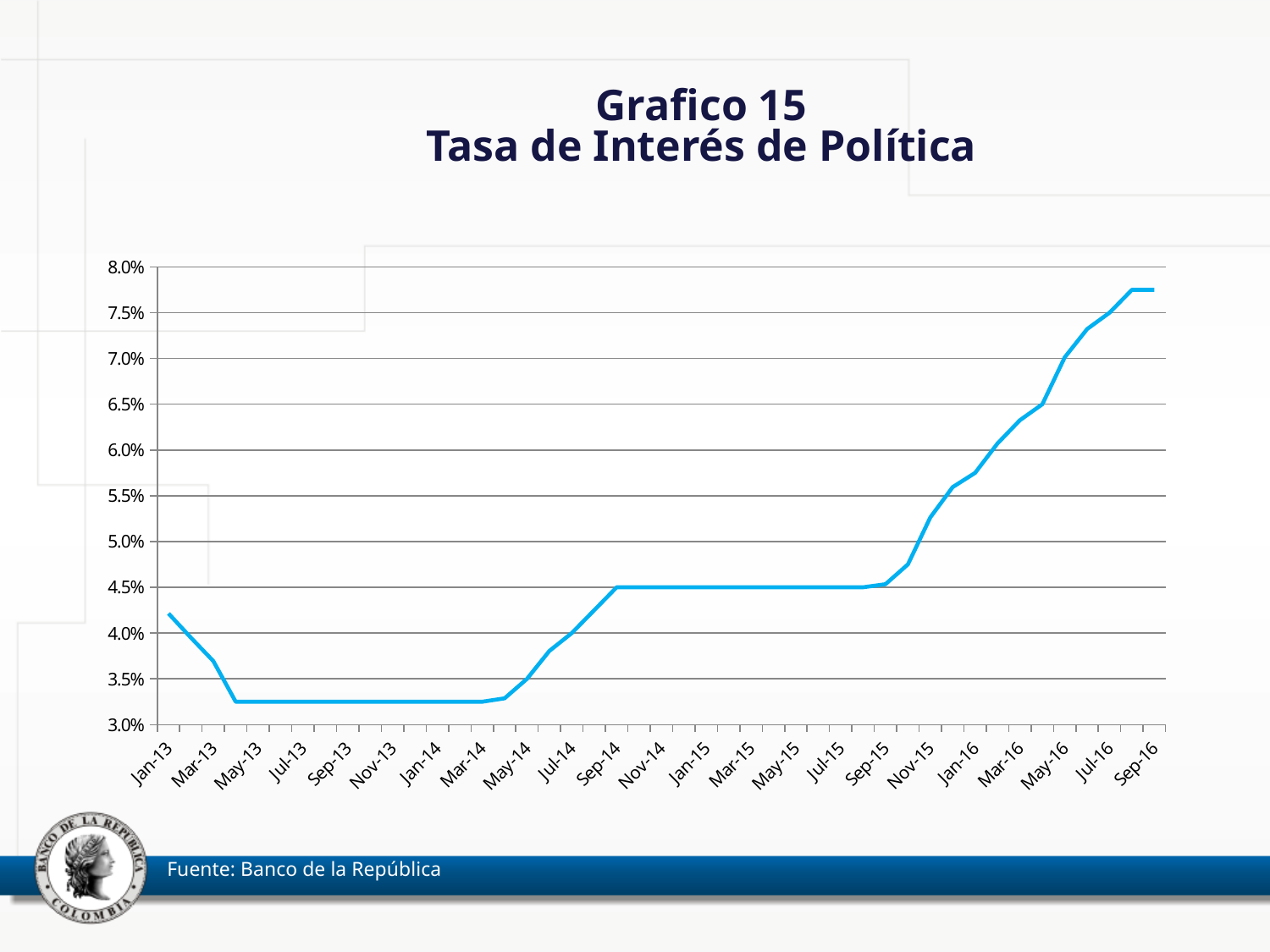
What is the title of the chart? Grafico 15 Tasa de Interés de Política Is the value for Jul-13 greater or less than 3.5%? less What source is cited for the chart? Banco de la República What is the policy interest rate in Jan-15? 4.5% Does the policy interest rate rise or fall between Sep-15 and Sep-16? rise Does the policy interest rate rise or fall between Jan-13 and May-13? fall Which is larger, the value for Jan-13 or the value for Sep-16? Sep-16 What kind of chart is shown on the slide? line chart What is the policy interest rate in Nov-14? 4.5% Is the value for Sep-16 greater or less than 7.5%? greater Is the value for Mar-16 greater or less than 6.0%? greater